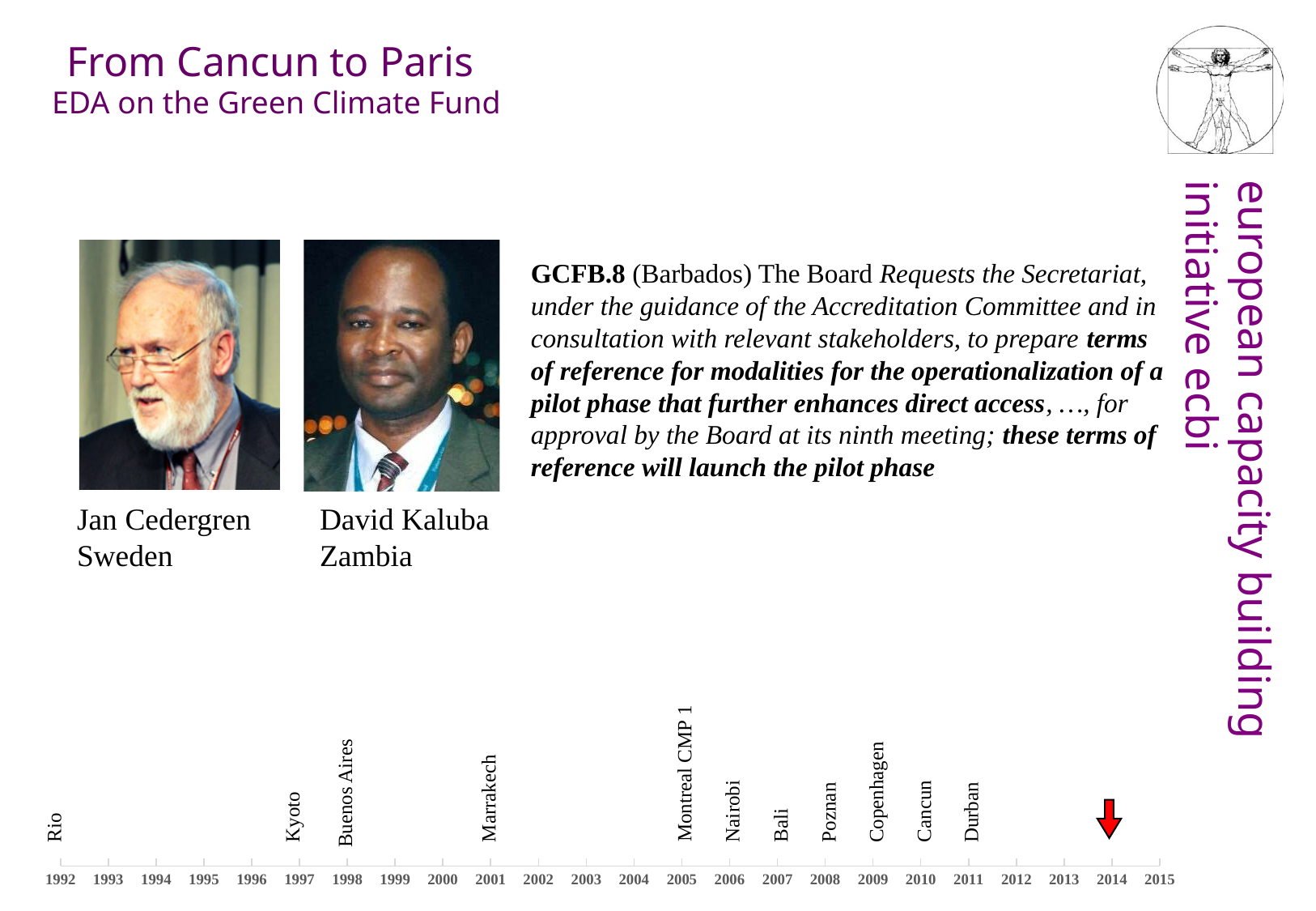
On the timeline at the bottom of the slide, at which year is Kyoto placed? 1997 On the timeline at the bottom of the slide, what is the last year shown on the axis? 2015 On the timeline at the bottom of the slide, how many year ticks are labelled on the axis? 24 On the timeline at the bottom of the slide, which comes earlier, Bali or Poznan? Bali On the timeline at the bottom of the slide, at which year is Copenhagen placed? 2009 On the timeline at the bottom of the slide, at which year does the red arrow point? 2014 On the timeline at the bottom of the slide, at which year is Montreal CMP 1 placed? 2005 On the timeline at the bottom of the slide, which event label is placed at 1992? Rio On the timeline at the bottom of the slide, what is the first year shown on the axis? 1992 On the timeline at the bottom of the slide, at which year is Durban placed? 2011 On the timeline at the bottom of the slide, how many named events are labelled? 11 On the timeline at the bottom of the slide, which event label is placed at 2010? Cancun